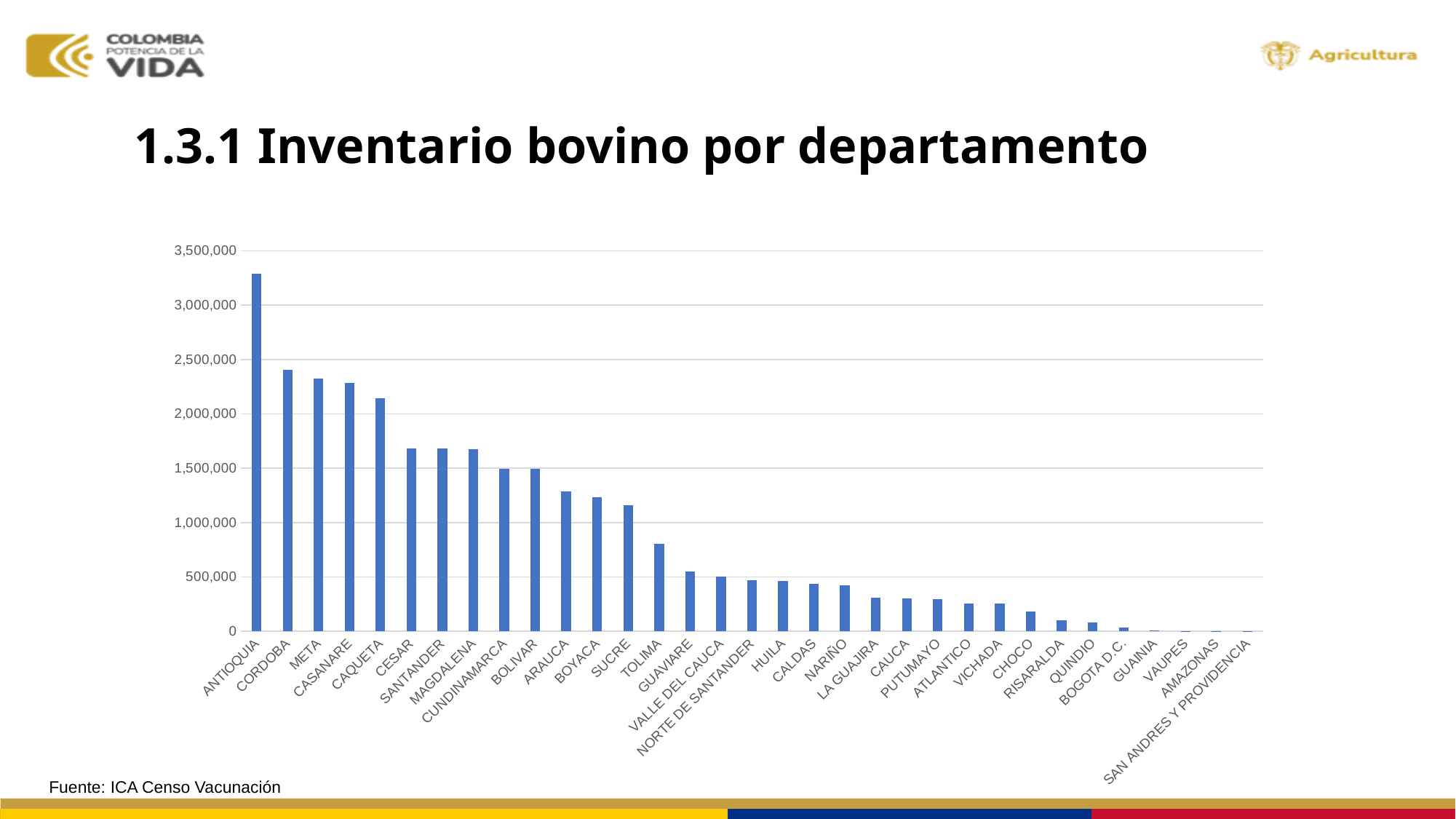
How many departments are shown on the x axis of the chart? 33 Is the value for TOLIMA greater or less than 1,000,000? less Which has a larger bovine inventory, CHOCO or ARAUCA? ARAUCA Is the value for CORDOBA greater or less than 2,500,000? less Is the value for CAQUETA greater or less than 2,000,000? greater What kind of chart is shown on the slide? bar chart Which department has the highest bovine inventory in the chart? ANTIOQUIA Which has a larger bovine inventory, META or SUCRE? META What is the title of the slide containing the chart? 1.3.1 Inventario bovino por departamento Do the bar values rise or fall moving from left to right along the x axis? fall